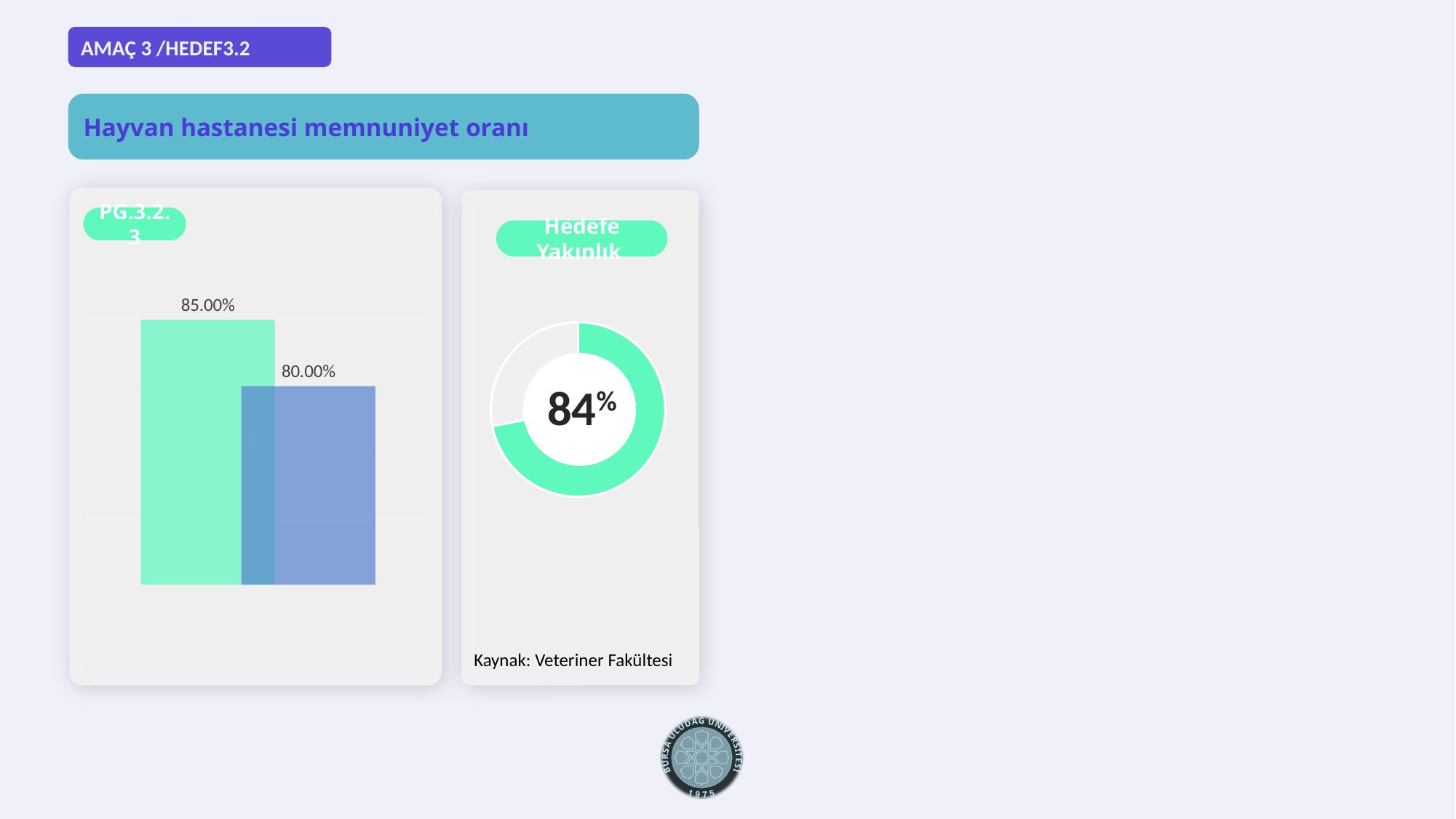
On the bar chart labelled PG.3.2.3, which bar is taller, the green one or the blue one? the green one What source is cited below the Hedefe Yakınlık chart? Veteriner Fakültesi What percentage is shown in the centre of the Hedefe Yakınlık chart? 84% What is the title shown in the teal banner above the charts? Hayvan hastanesi memnuniyet oranı On the bar chart labelled PG.3.2.3, what value is printed above the green bar? 85.00% On the bar chart labelled PG.3.2.3, which bar has the highest value? the green bar On the bar chart labelled PG.3.2.3, what is the difference between the green bar's value and the blue bar's value? 5.00% What kind of chart is the chart labelled PG.3.2.3? bar chart On the bar chart labelled PG.3.2.3, how many bars are plotted? 2 On the bar chart labelled PG.3.2.3, which bar has the lowest value? the blue bar On the bar chart labelled PG.3.2.3, what value is printed above the blue bar? 80.00% What kind of chart is the Hedefe Yakınlık chart? donut chart